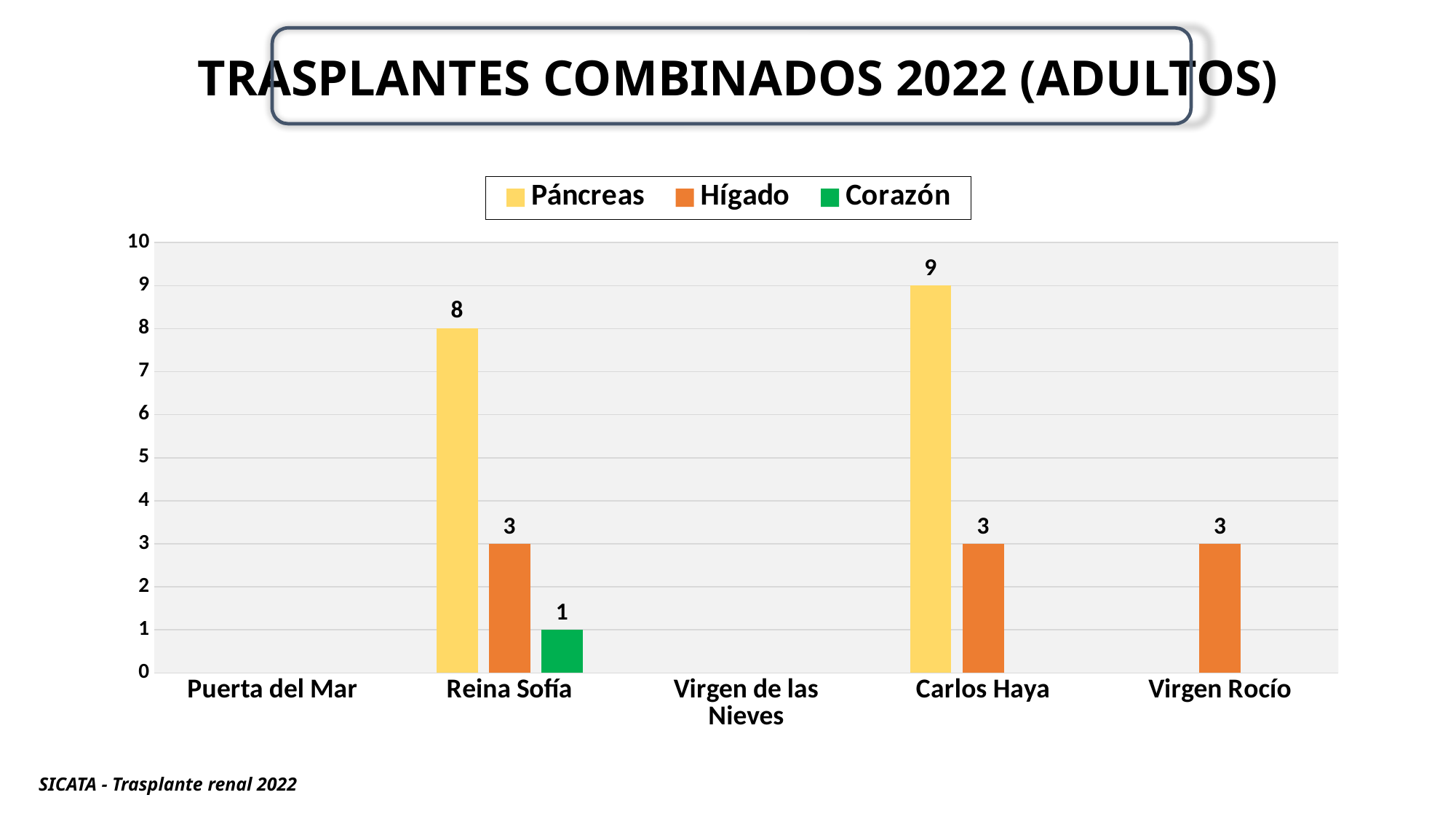
What is the Páncreas value for Reina Sofía? 8 What is the Corazón value for Reina Sofía? 1 How many series does the legend list? 3 What is the title of the chart? TRASPLANTES COMBINADOS 2022 (ADULTOS) What is the Páncreas value for Carlos Haya? 9 What kind of chart is shown on the slide? Bar chart Which hospital has the highest Páncreas value? Carlos Haya Which series is shown in green in the legend? Corazón What is the Hígado value for Virgen Rocío? 3 What is the difference between the Páncreas values for Carlos Haya and Reina Sofía? 1 Which is larger, the Páncreas value for Reina Sofía or the Hígado value for Reina Sofía? Páncreas How many hospitals are shown on the x axis? 5